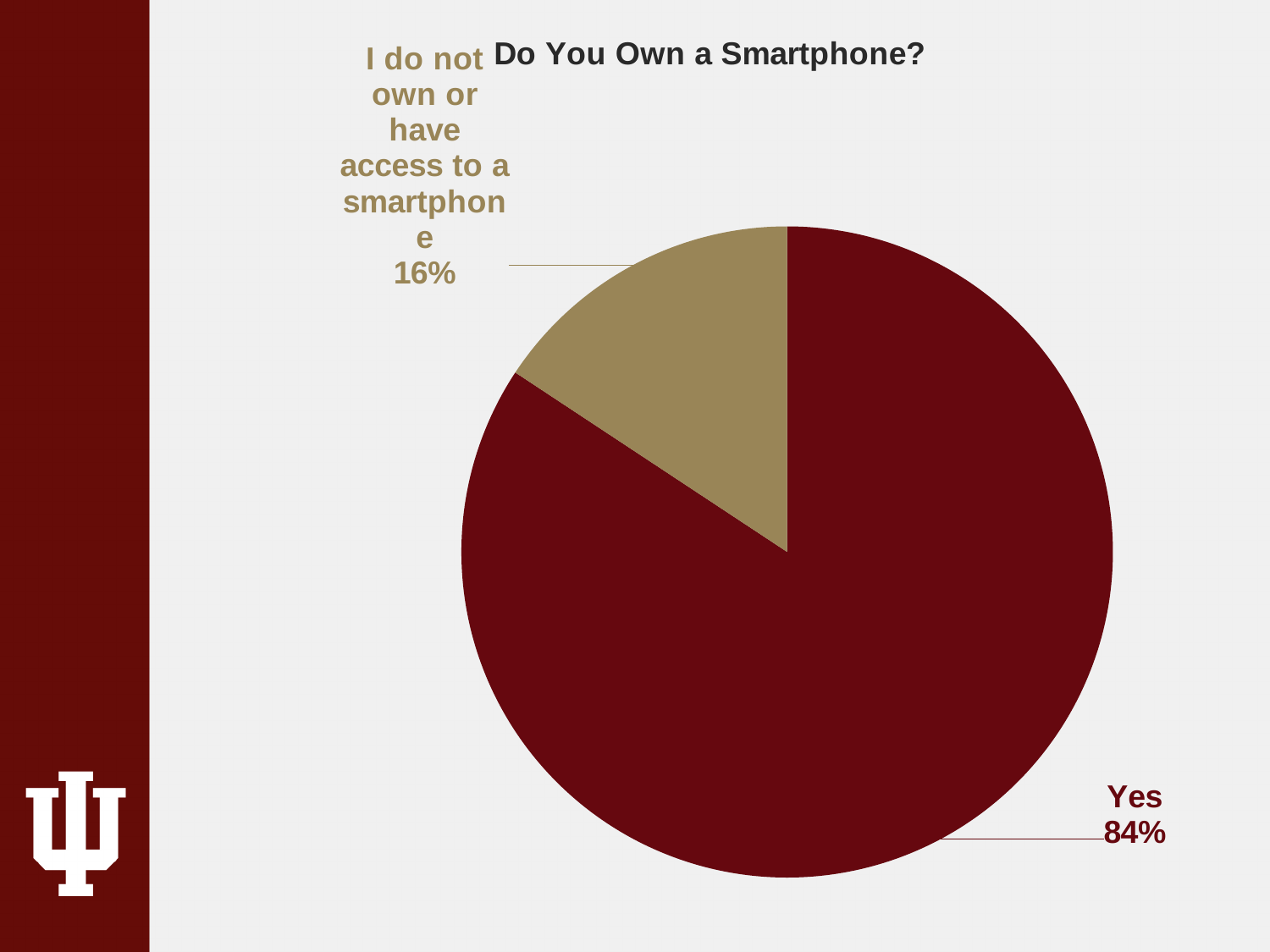
What share of the pie does the "Yes" slice represent? 84% What kind of chart is shown on the slide? pie chart What is the title of the chart? Do You Own a Smartphone? What percentage of respondents said they do not own or have access to a smartphone? 16% What percentage of respondents answered "Yes"? 84% What colour is the "Yes" slice? dark red Which is larger: the "Yes" slice or the "I do not own or have access to a smartphone" slice? Yes What is the difference in percentage points between the "Yes" slice and the "I do not own or have access to a smartphone" slice? 68 Which slice of the pie is the smallest? I do not own or have access to a smartphone How many slices does the pie chart have? 2 Which slice of the pie is the largest? Yes